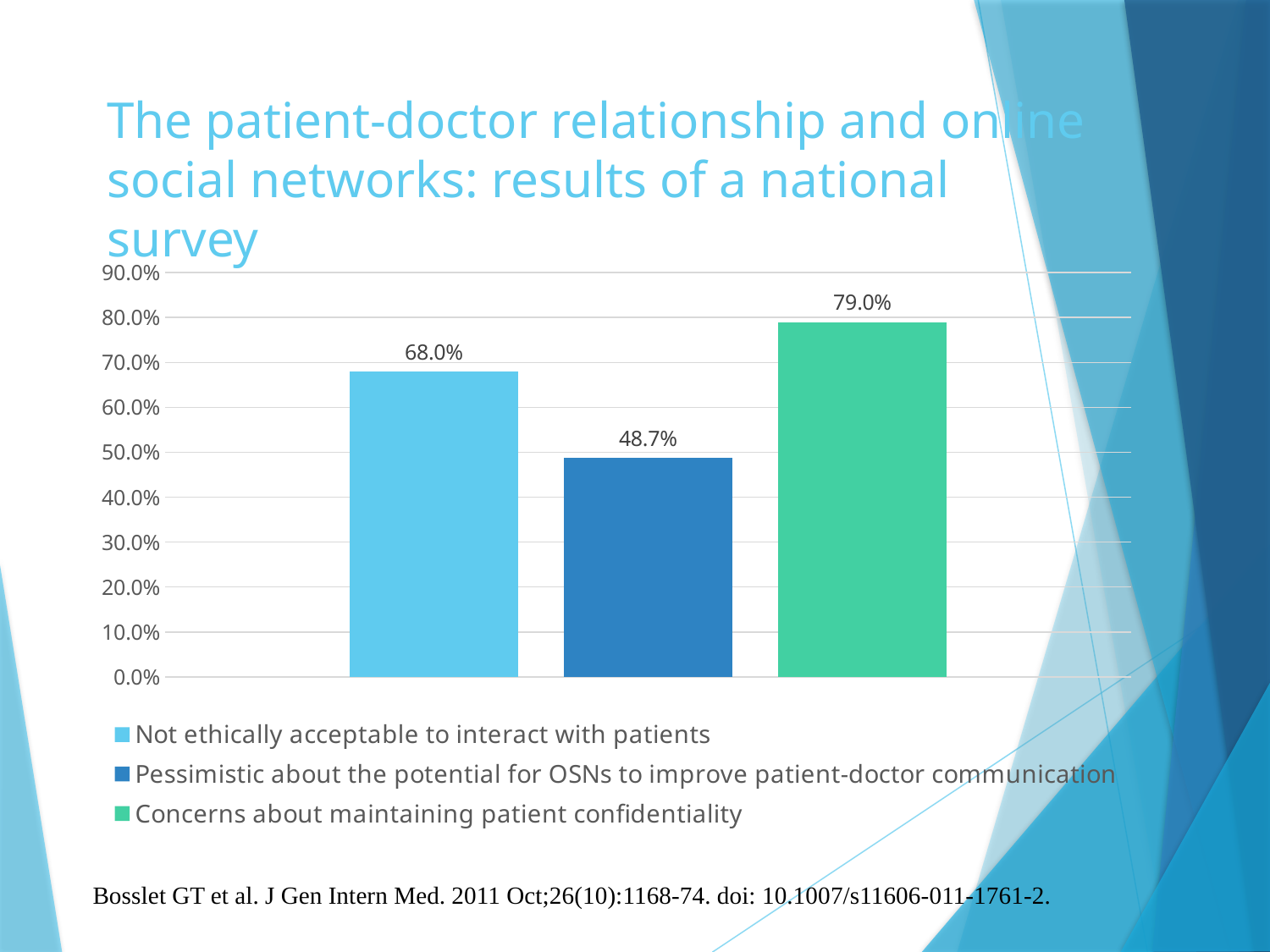
What is the difference between the values for "Not ethically acceptable to interact with patients" and "Pessimistic about the potential for OSNs to improve patient-doctor communication"? 19.3% Which series has the lowest value? Pessimistic about the potential for OSNs to improve patient-doctor communication What is the difference between the values for "Concerns about maintaining patient confidentiality" and "Not ethically acceptable to interact with patients"? 11.0% What is the value for "Pessimistic about the potential for OSNs to improve patient-doctor communication"? 48.7% What kind of chart is shown on the slide? Bar chart Which series has the highest value? Concerns about maintaining patient confidentiality How many bars are plotted on the chart? 3 Which is larger: the value for "Not ethically acceptable to interact with patients" or the value for "Pessimistic about the potential for OSNs to improve patient-doctor communication"? Not ethically acceptable to interact with patients How many series does the legend list? 3 What is the value for "Not ethically acceptable to interact with patients"? 68.0% Is the value for "Pessimistic about the potential for OSNs to improve patient-doctor communication" greater or less than 50.0%? less What is the value for "Concerns about maintaining patient confidentiality"? 79.0%